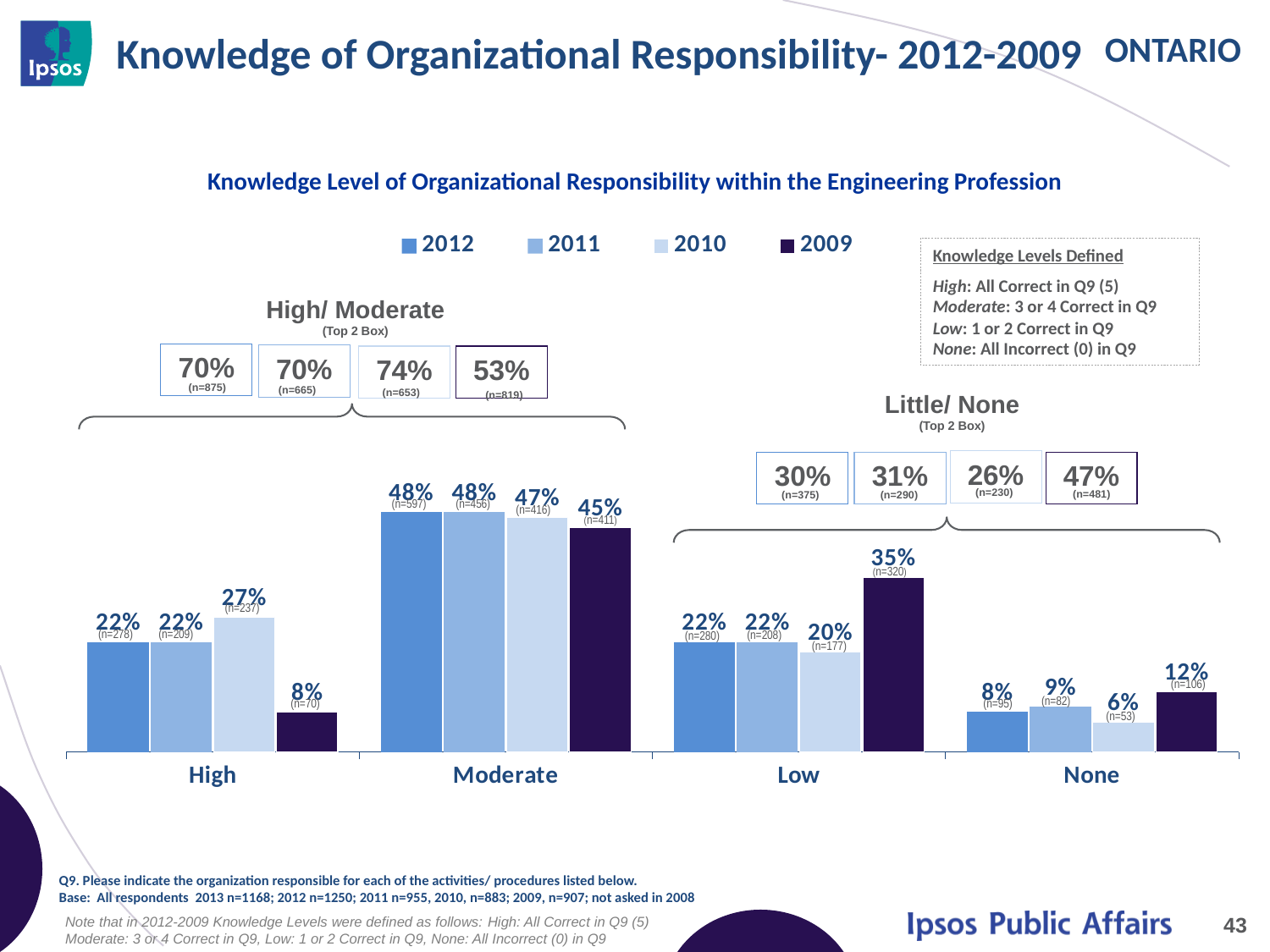
What is the High/Moderate (Top 2 Box) value shown for 2009? 53% How many series does the legend list? 4 Which year has the lowest value in the High category? 2009 How many categories are shown on the x axis? 4 What is the value for 2009 in the Low category? 35% What is the difference between the 2009 and 2012 values in the Low category? 13 percentage points What is the value for 2012 in the Moderate category? 48% What is the value for 2010 in the None category? 6% Which year has the highest value in the Low category? 2009 What kind of chart is shown on the slide? Bar chart What is the value for 2010 in the High category? 27% Which is larger in the None category: the 2009 value or the 2011 value? 2009